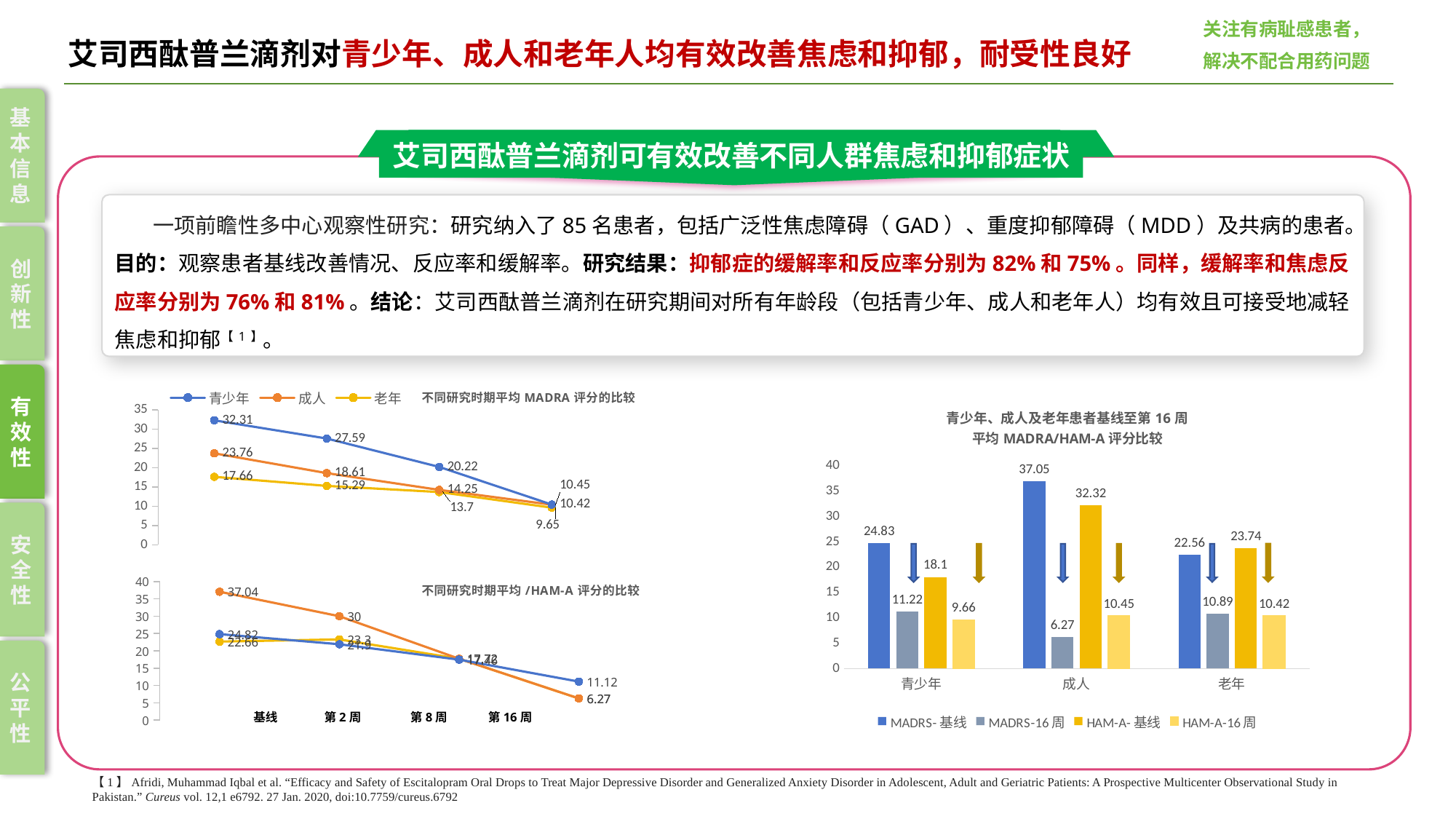
In the bar chart on the right, how many patient groups are shown on the x axis? 3 In the top-left chart (不同研究时期平均 MADRA 评分的比较), do the values for 青少年 rise or fall from 基线 to 第16周? fall In the bar chart on the right, what is the HAM-A-16周 value for 青少年? 9.66 In the bar chart on the right, how many series does the legend list? 4 In the bar chart on the right, what is the MADRS-基线 value for 成人? 37.05 In the bar chart on the right, which group has the lowest MADRS-16周 value? 成人 What kind of chart is the chart on the right of the slide? bar chart In the top-left chart (不同研究时期平均 MADRA 评分的比较), what is the baseline value for 青少年? 32.31 In the bar chart on the right, what is the difference between the HAM-A-基线 and HAM-A-16周 values for 老年? 13.32 In the top-left chart (不同研究时期平均 MADRA 评分的比较), what is the 第2周 value for 成人? 18.61 In the bottom-left chart (不同研究时期平均 /HAM-A 评分的比较), what is the 第16周 value for 成人? 6.27 In the bar chart on the right, which group has the highest MADRS-基线 value? 成人